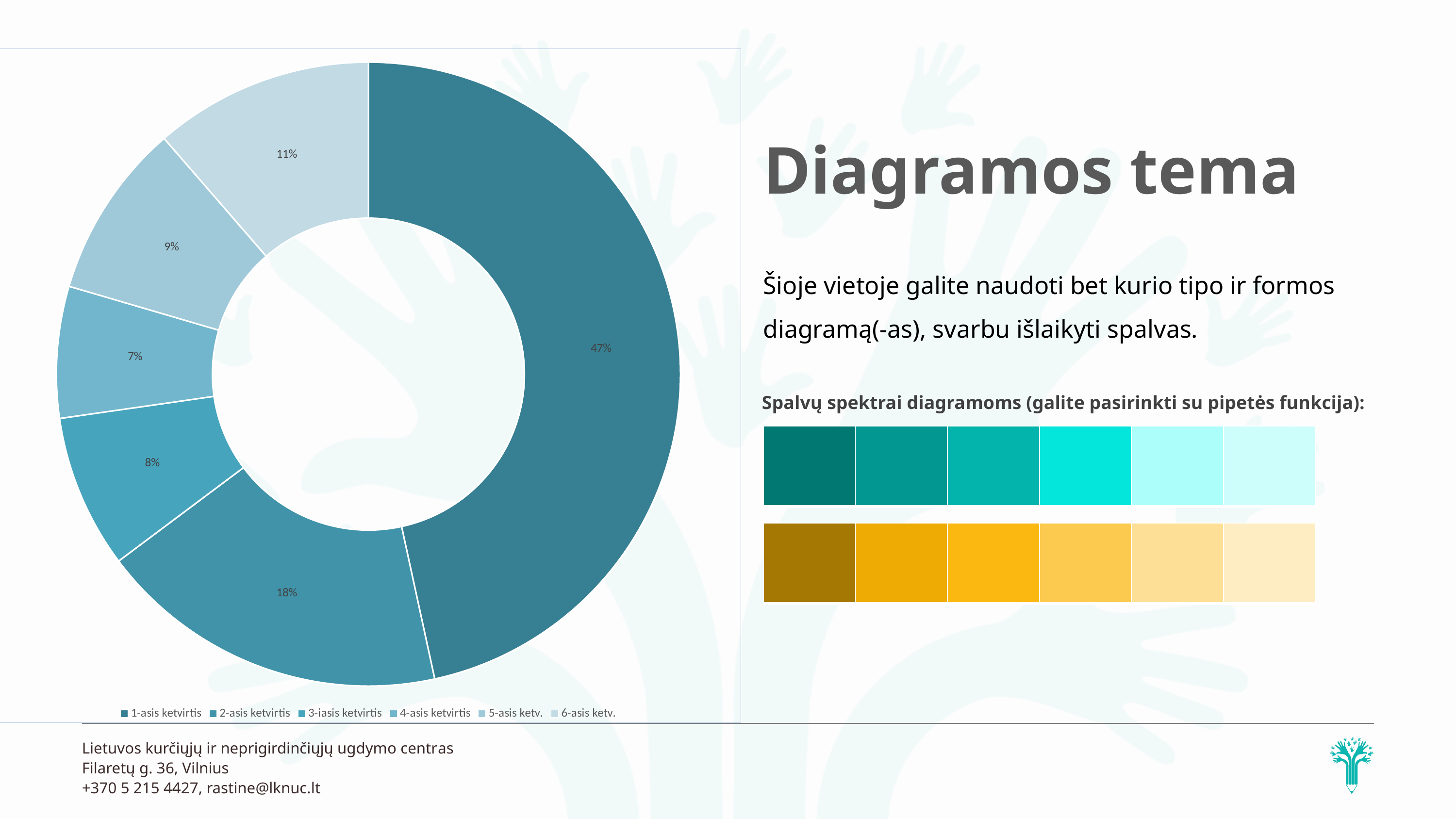
Which is larger, the 3-iasis ketvirtis slice or the 6-asis ketv. slice? 6-asis ketv. What share of the whole does the 3-iasis ketvirtis slice represent? 8% How many entries does the legend list? 6 Which category has the largest slice? 1-asis ketvirtis How many slices does the chart have? 6 What is the difference between the 1-asis ketvirtis and 2-asis ketvirtis slices? 29% What percentage does the 6-asis ketv. slice show? 11% Which category has the smallest slice? 4-asis ketvirtis What percentage does the 1-asis ketvirtis slice show? 47% What percentage does the 2-asis ketvirtis slice show? 18% What kind of chart is shown on the slide? doughnut chart What percentage does the 5-asis ketv. slice show? 9%